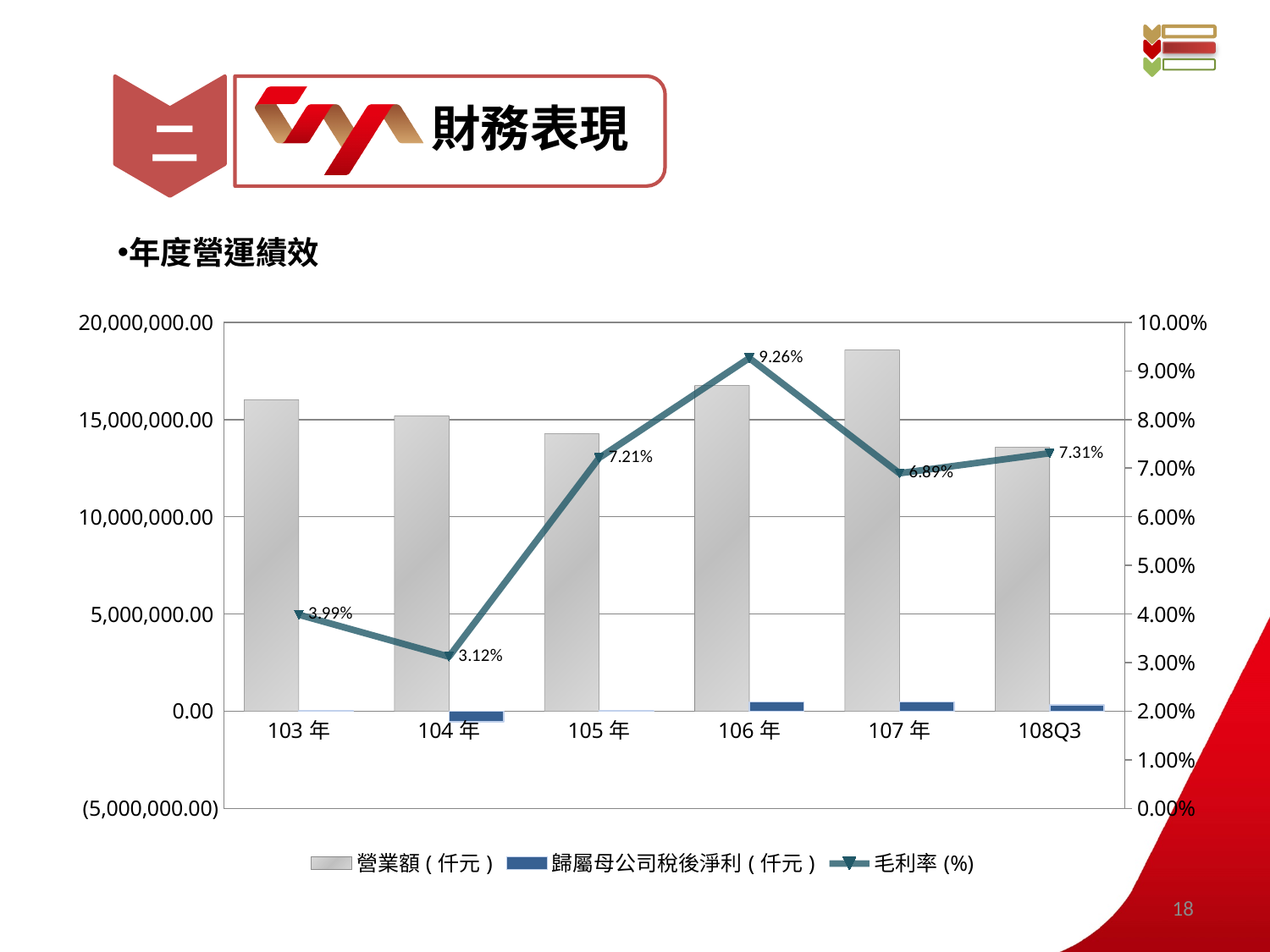
What is the gross margin (毛利率) for 106 年? 9.26% How many periods are shown on the x axis? 6 How many series does the legend list? 3 What is the gross margin (毛利率) for 108Q3? 7.31% Which period has the highest revenue (營業額) bar? 107 年 What is the difference between the gross margin for 106 年 and 104 年? 6.14% What is the gross margin (毛利率) for 104 年? 3.12% Which period has the highest gross margin (毛利率)? 106 年 Which period has the lowest gross margin (毛利率)? 104 年 Is the revenue (營業額) for 108Q3 greater or less than 15,000,000.00? less Is the gross margin for 107 年 or 108Q3 higher? 108Q3 Is the revenue (營業額) for 107 年 greater or less than 15,000,000.00? greater